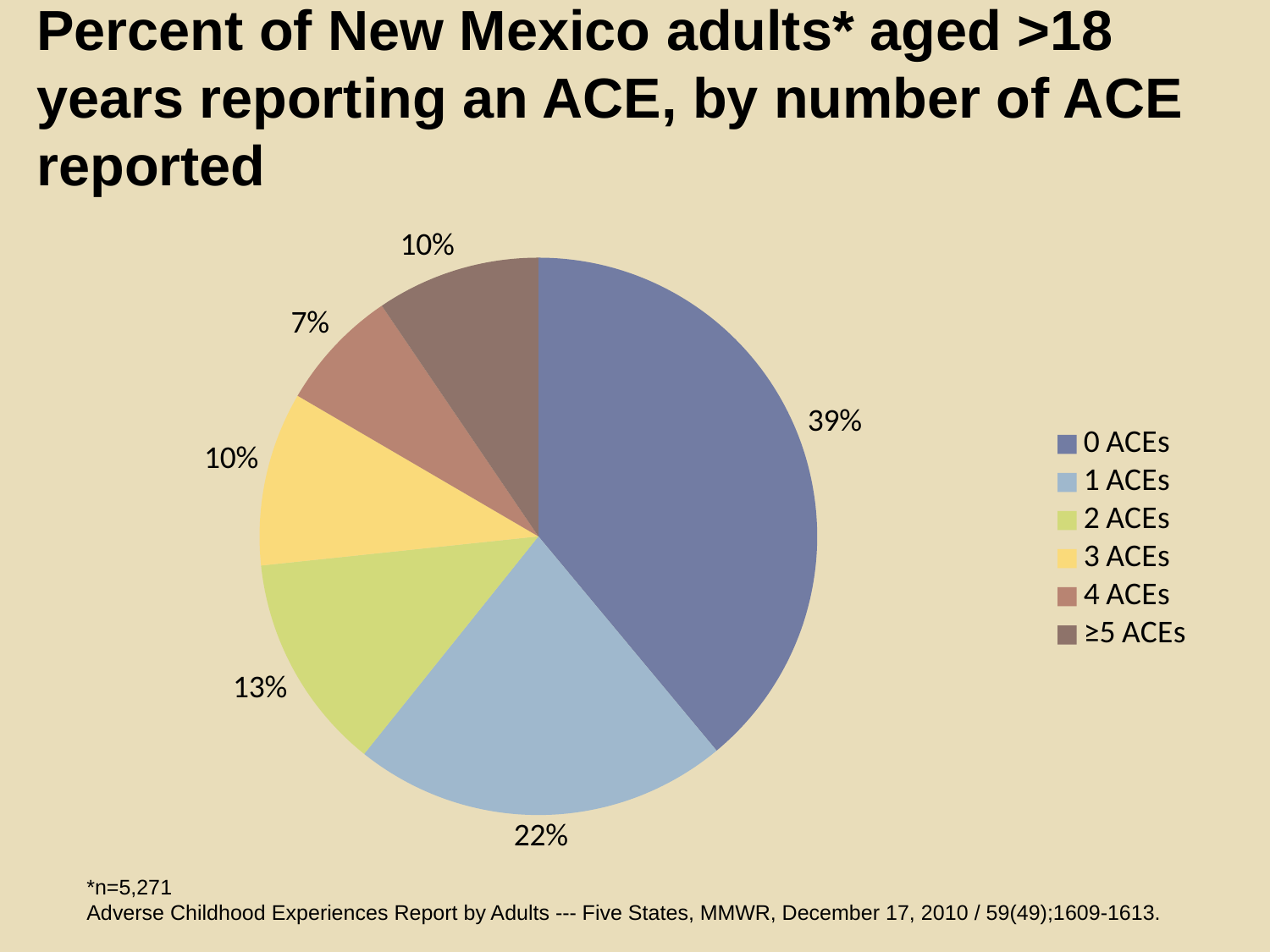
What type of chart is shown on the slide? Pie chart What percentage of New Mexico adults reported 2 ACEs? 13% What is the difference between the share for 0 ACEs and the share for 1 ACEs? 17% What is the combined share of adults reporting 3 ACEs and ≥5 ACEs? 20% Which category has the smallest share of the pie? 4 ACEs Which is larger, the share for 2 ACEs or the share for 4 ACEs? 2 ACEs What percentage of New Mexico adults reported 1 ACEs? 22% What percentage of New Mexico adults reported 4 ACEs? 7% How many categories does the pie chart have? 6 What is the sample size (n) noted on the slide? 5,271 Which category has the largest share of the pie? 0 ACEs What percentage of New Mexico adults reported 0 ACEs? 39%